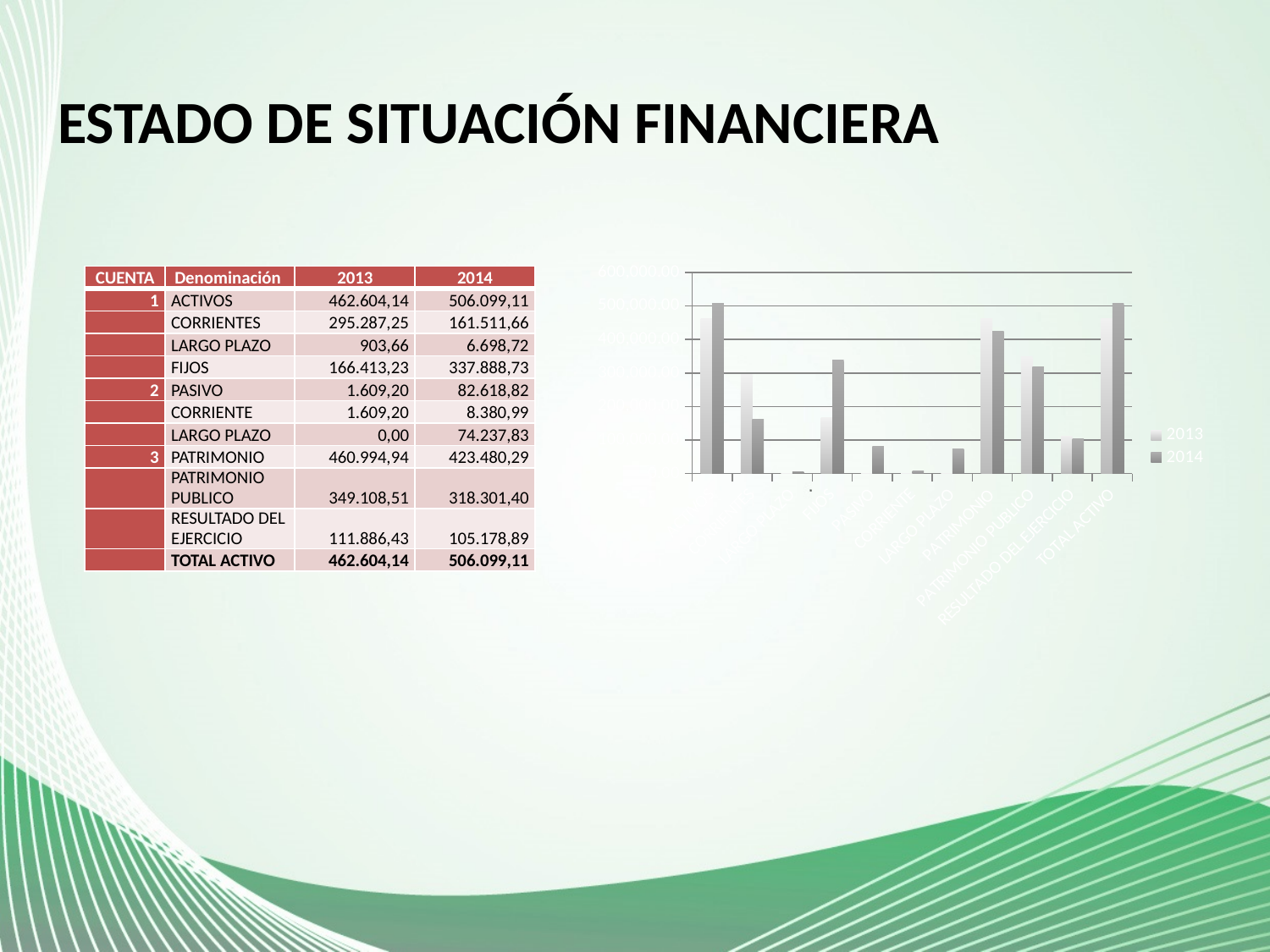
Is the 2013 value for ACTIVOS greater or less than 400.000,00? greater Is the 2014 value for PASIVO greater or less than 100.000,00? less For PATRIMONIO, which year has the larger value, 2013 or 2014? 2013 How many series does the chart legend list? 2 How many categories are plotted along the x axis of the chart? 11 What is the 2014 value for FIJOS shown on the slide? 337.888,73 For FIJOS, which year has the larger value, 2013 or 2014? 2014 What kind of chart is shown on the slide? bar chart Which years are listed in the chart legend? 2013 and 2014 What is the difference between the 2014 and 2013 values for ACTIVOS shown on the slide? 43.494,97 For CORRIENTES, which year has the larger value, 2013 or 2014? 2013 Is the 2014 value for FIJOS greater or less than 300.000,00? greater